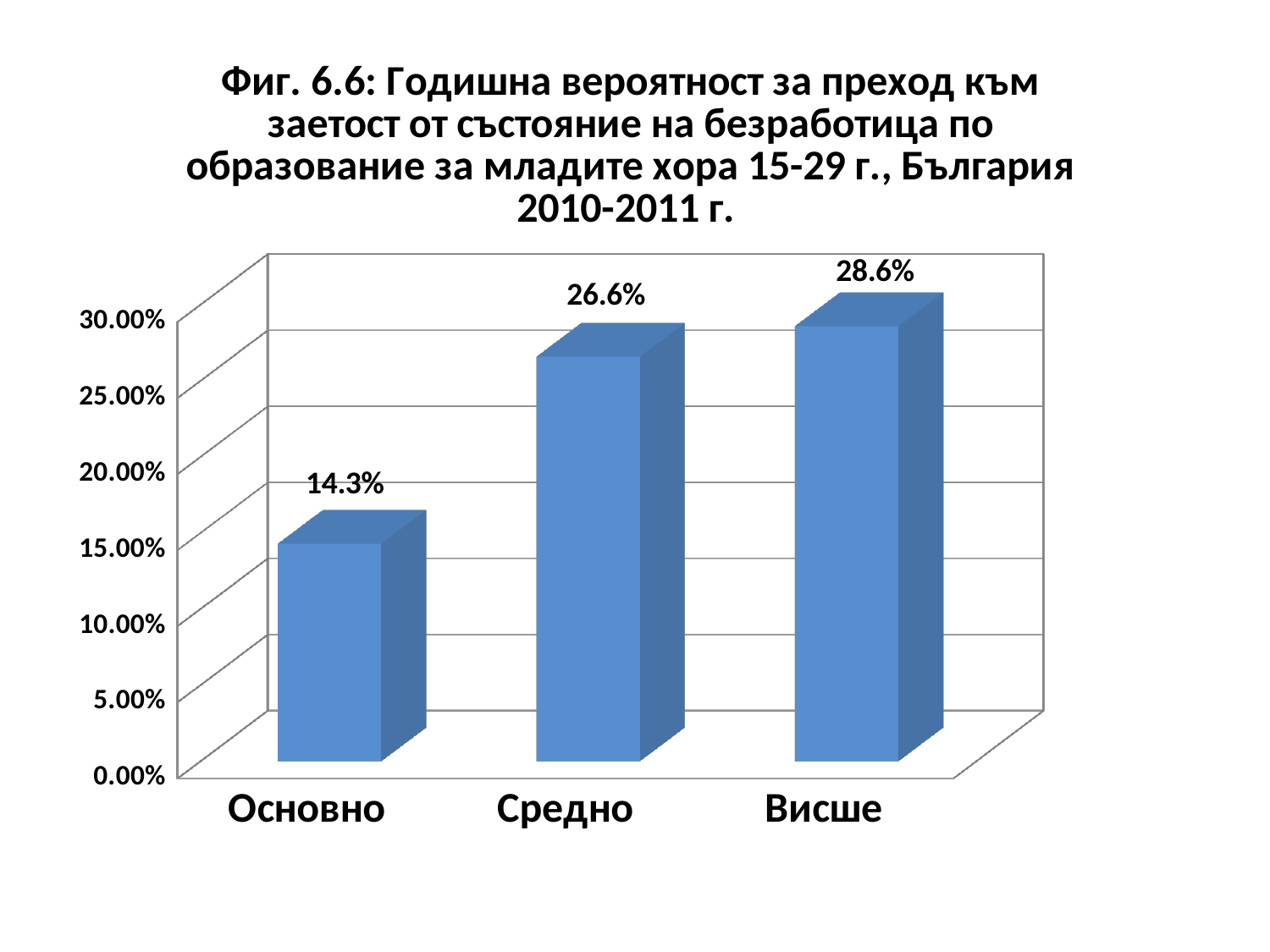
What is the difference between the values for Средно and Основно? 12.3% How many categories are shown on the x axis? 3 What kind of chart is shown on the slide? bar chart What is the value for Висше? 28.6% What is the value for Средно? 26.6% Which category has the lowest value? Основно Do the values rise or fall from Основно to Висше along the x axis? rise Which category has the highest value? Висше What is the value for Основно? 14.3% Is the value for Основно greater or less than 15.00%? less What is the difference between the values for Висше and Средно? 2.0% Which is larger, the value for Основно or the value for Средно? Средно